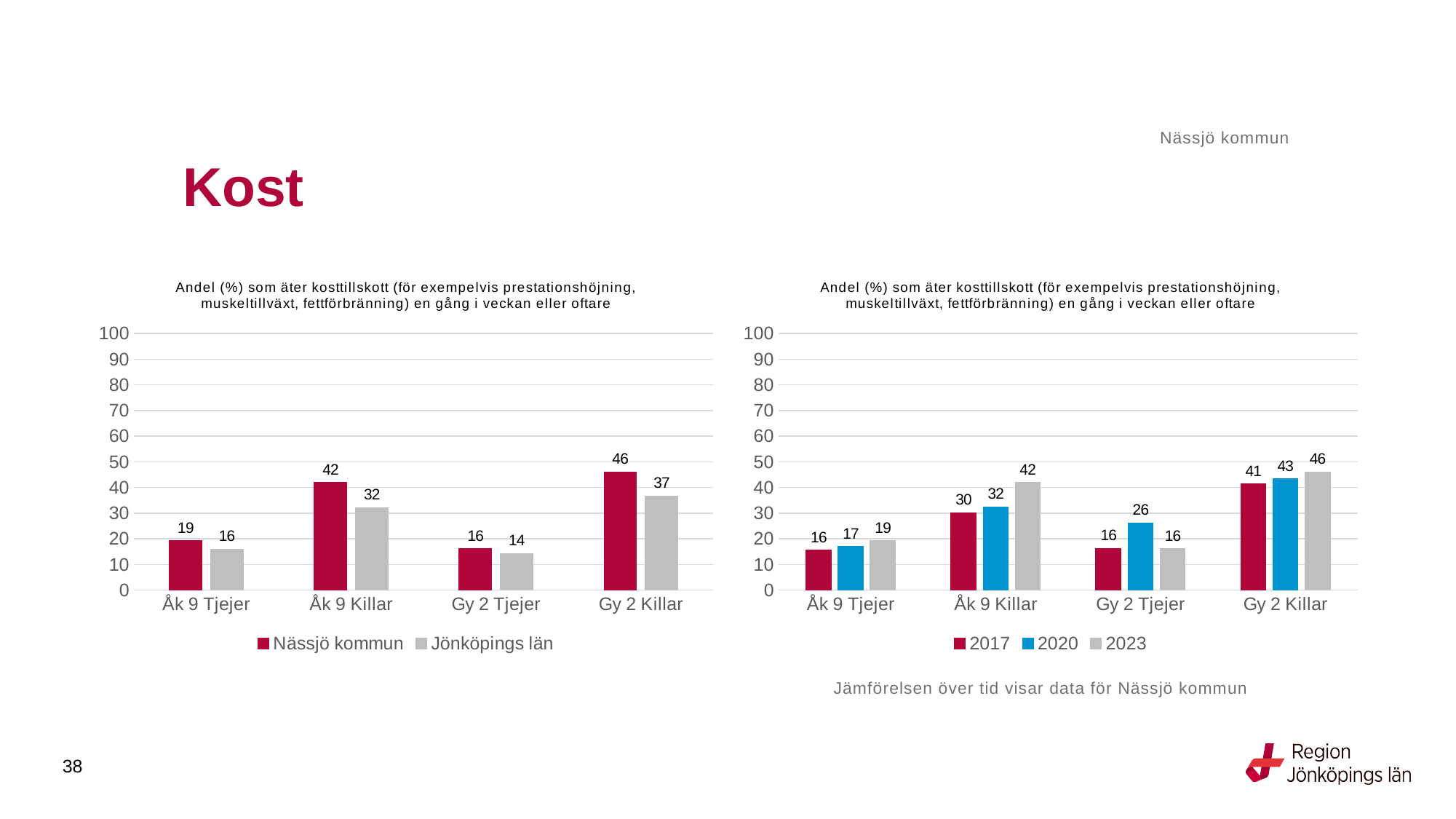
In the left chart, which category has the highest value for Nässjö kommun? Gy 2 Killar In the right chart, how many series does the legend list? 3 In the left chart, what is the value for Jönköpings län for Gy 2 Tjejer? 14 In the right chart, which is larger for Gy 2 Killar: the 2017 value or the 2023 value? 2023 In the left chart, what is the difference between Nässjö kommun and Jönköpings län for Gy 2 Killar? 9 In the right chart, what is the value for 2023 for Åk 9 Killar? 42 What type of chart is the right chart? Bar chart In the right chart, what is the difference between the 2023 and 2017 values for Åk 9 Killar? 12 In the right chart, what is the value for 2020 for Gy 2 Tjejer? 26 In the left chart, which category has the lowest value for Jönköpings län? Gy 2 Tjejer In the left chart, what is the value for Nässjö kommun for Åk 9 Killar? 42 In the left chart, how many series does the legend list? 2